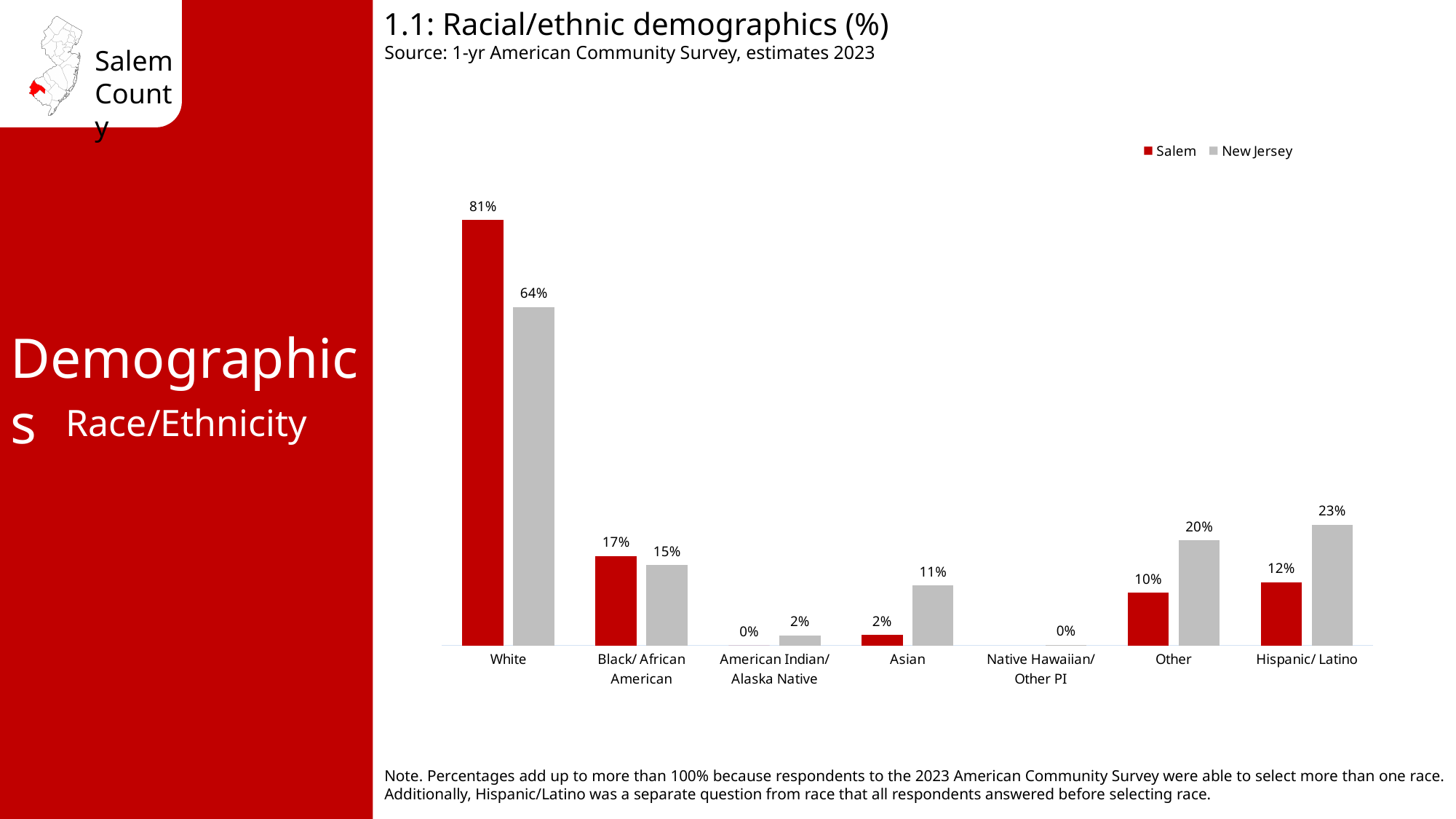
How many racial/ethnic categories are shown on the x axis? 7 In the Other category, which is larger: the Salem value or the New Jersey value? New Jersey What is the value for New Jersey in the Asian category? 11% What is the value for Salem in the Hispanic/ Latino category? 12% What is the value for New Jersey in the White category? 64% What kind of chart is shown on the slide? Bar chart What is the difference between the Salem and New Jersey values in the White category? 17 percentage points How many series does the legend list? 2 What is the difference between the New Jersey and Salem values in the Hispanic/ Latino category? 11 percentage points What is the value for Salem in the White category? 81% What is the value for Salem in the Black/ African American category? 17% Which category has the highest value for Salem? White